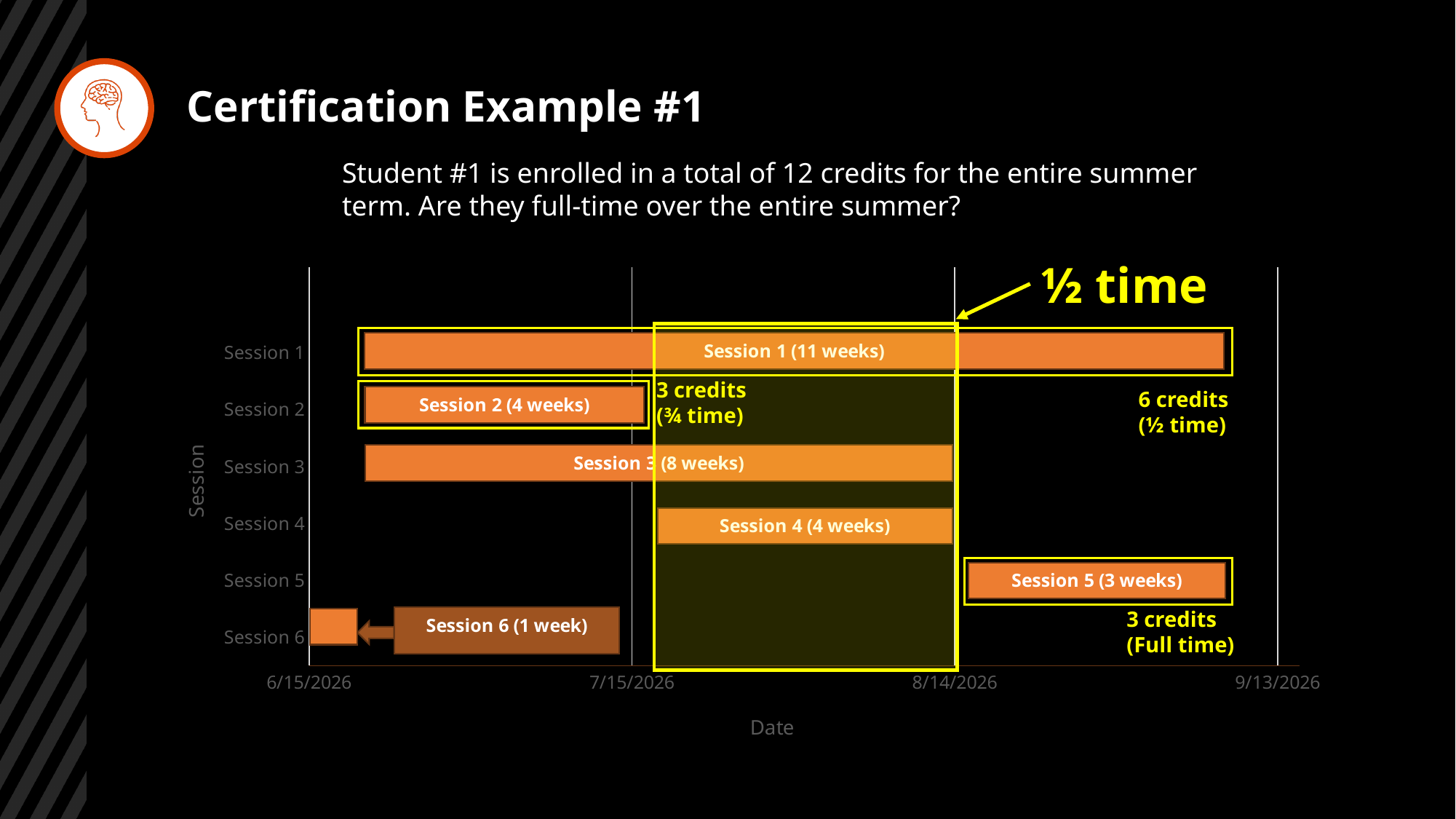
Which session has the longest duration? Session 1 How long is Session 5 according to its bar label? 3 weeks What is the title of the horizontal axis? Date How many weeks longer is Session 3 than Session 4? 4 weeks How many sessions are plotted on the chart? 6 How long is Session 1 according to its bar label? 11 weeks What kind of chart is shown on the slide? Bar chart (Gantt-style horizontal bars) How long is Session 3 according to its bar label? 8 weeks Which is longer, Session 2 or Session 5? Session 2 What is the title of the vertical axis? Session Which session has the shortest duration? Session 6 How many weeks longer is Session 1 than Session 3? 3 weeks